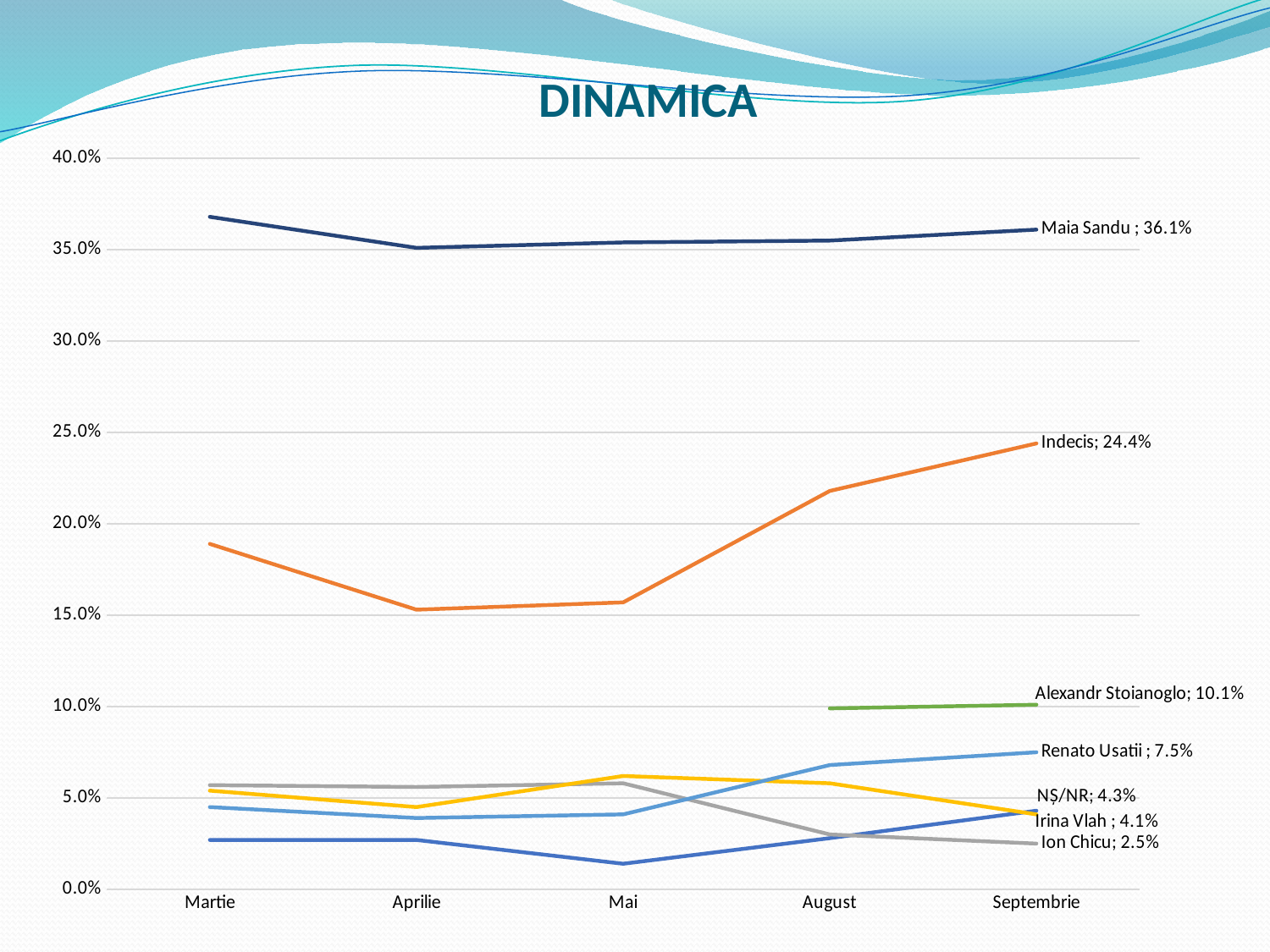
What is the difference between Maia Sandu and Indecis in Septembrie? 11.7% What is the value for Maia Sandu in Septembrie? 36.1% Which series has the lowest value in Septembrie? Ion Chicu Is the value for Indecis in Aprilie greater or less than 20%? less Which series has the highest value in Septembrie? Maia Sandu What is the value for Alexandr Stoianoglo in Septembrie? 10.1% In Septembrie, which is larger: Indecis or Alexandr Stoianoglo? Indecis What is the value for Indecis in Septembrie? 24.4% How many months are shown on the x axis? 5 What kind of chart is shown on the slide? line chart Is the value for Maia Sandu in Martie greater or less than 35%? greater What is the value for Ion Chicu in Septembrie? 2.5%